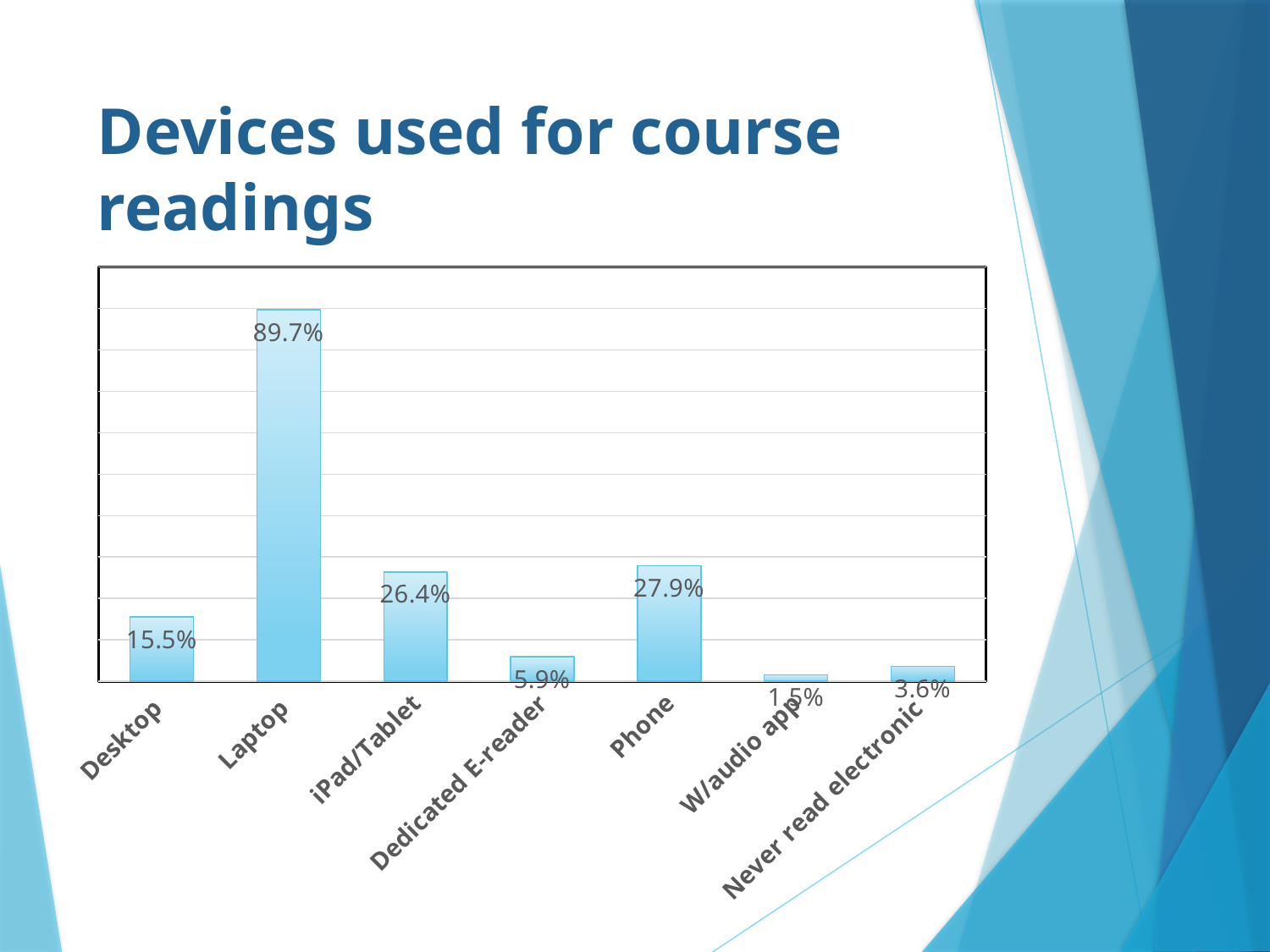
What is the difference between the Laptop value and the Desktop value? 74.2 percentage points What is the value shown for Dedicated E-reader? 5.9% What is the difference between the Phone value and the iPad/Tablet value? 1.5 percentage points What is the title of the slide? Devices used for course readings What is the value shown for Never read electronic? 3.6% Which is larger, the value for iPad/Tablet or the value for Desktop? iPad/Tablet Which device category has the highest value? Laptop Which category has the lowest value? W/audio app What is the value shown for Phone? 27.9% What percentage of respondents use a laptop for course readings? 89.7% What kind of chart is shown on the slide? Bar chart How many device categories are shown on the chart? 7